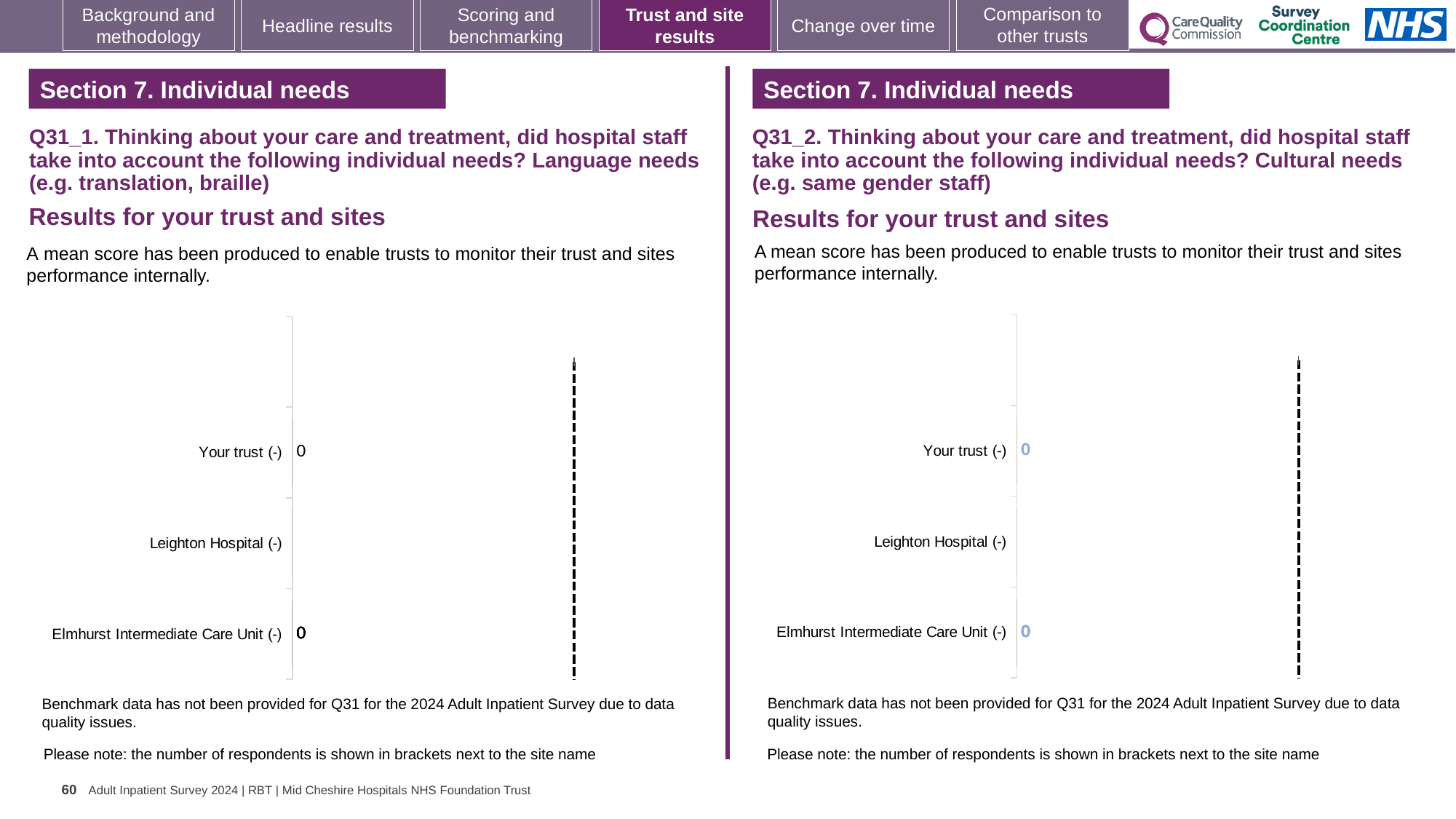
In the left chart (Q31_1, Language needs), what value is shown for Your trust? 0 In the right chart (Q31_2, Cultural needs), what value is shown for Elmhurst Intermediate Care Unit? 0 In the left chart (Q31_1, Language needs), how many categories are listed on the vertical axis? 3 In the right chart (Q31_2, Cultural needs), what is the label of the first category at the top of the axis? Your trust (-) In the right chart (Q31_2, Cultural needs), how many categories are listed on the vertical axis? 3 In the left chart (Q31_1, Language needs), what value is shown for Elmhurst Intermediate Care Unit? 0 In the left chart (Q31_1, Language needs), which category is listed between Your trust and Elmhurst Intermediate Care Unit? Leighton Hospital (-) In the right chart (Q31_2, Cultural needs), what value is shown for Your trust? 0